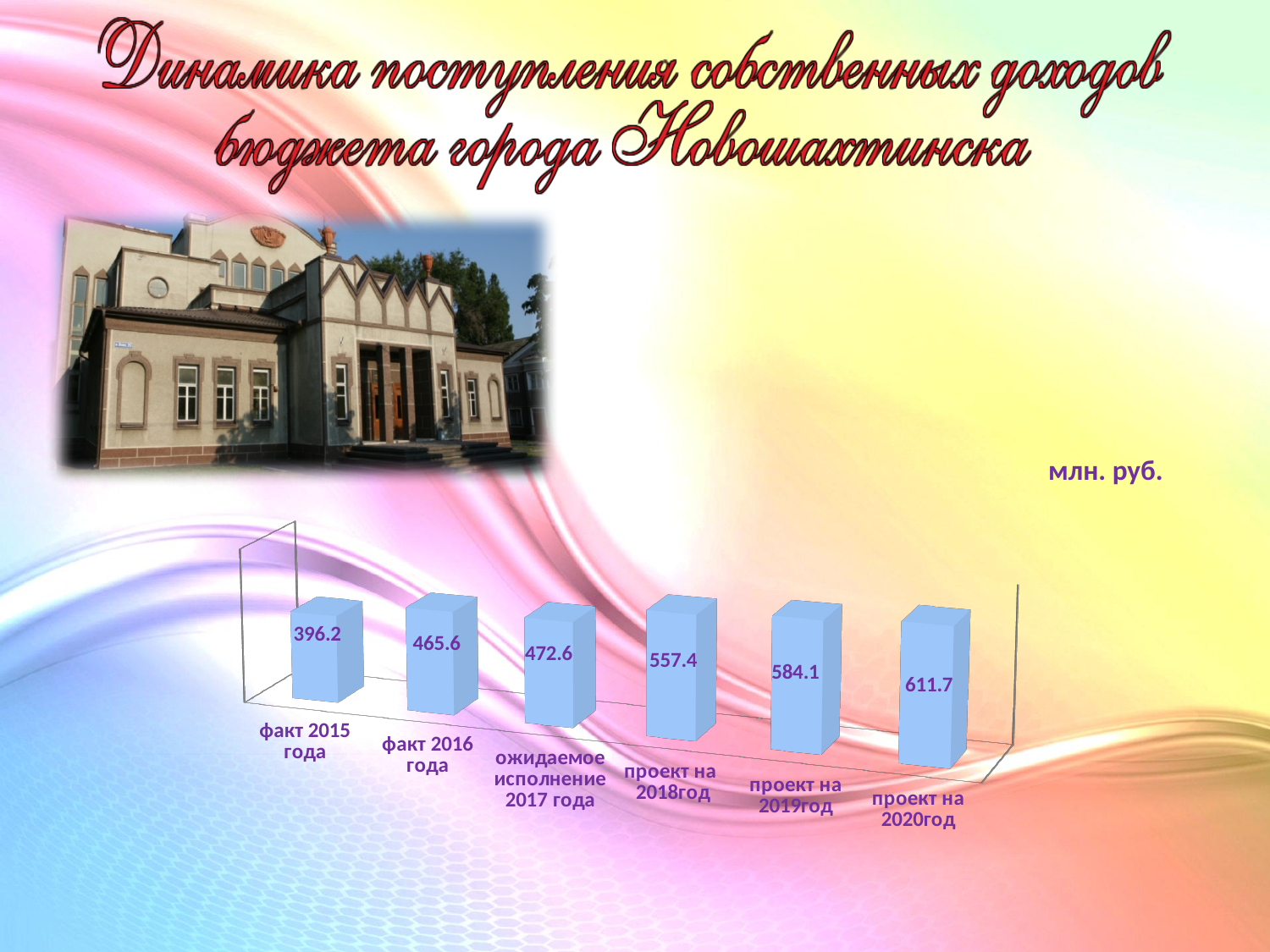
What is the difference between the values for проект на 2020год and факт 2015 года? 215.5 How many categories are shown in the chart? 6 What is the value for ожидаемое исполнение 2017 года? 472.6 What is the value for факт 2015 года? 396.2 What is the value for проект на 2018год? 557.4 Which category has the highest value? проект на 2020год Do the values rise or fall from факт 2015 года to проект на 2020год? rise Which category has the lowest value? факт 2015 года What kind of chart is shown on the slide? bar chart Which is larger, the value for проект на 2019год or the value for проект на 2018год? проект на 2019год What is the difference between the values for факт 2016 года and факт 2015 года? 69.4 What is the value for проект на 2020год? 611.7